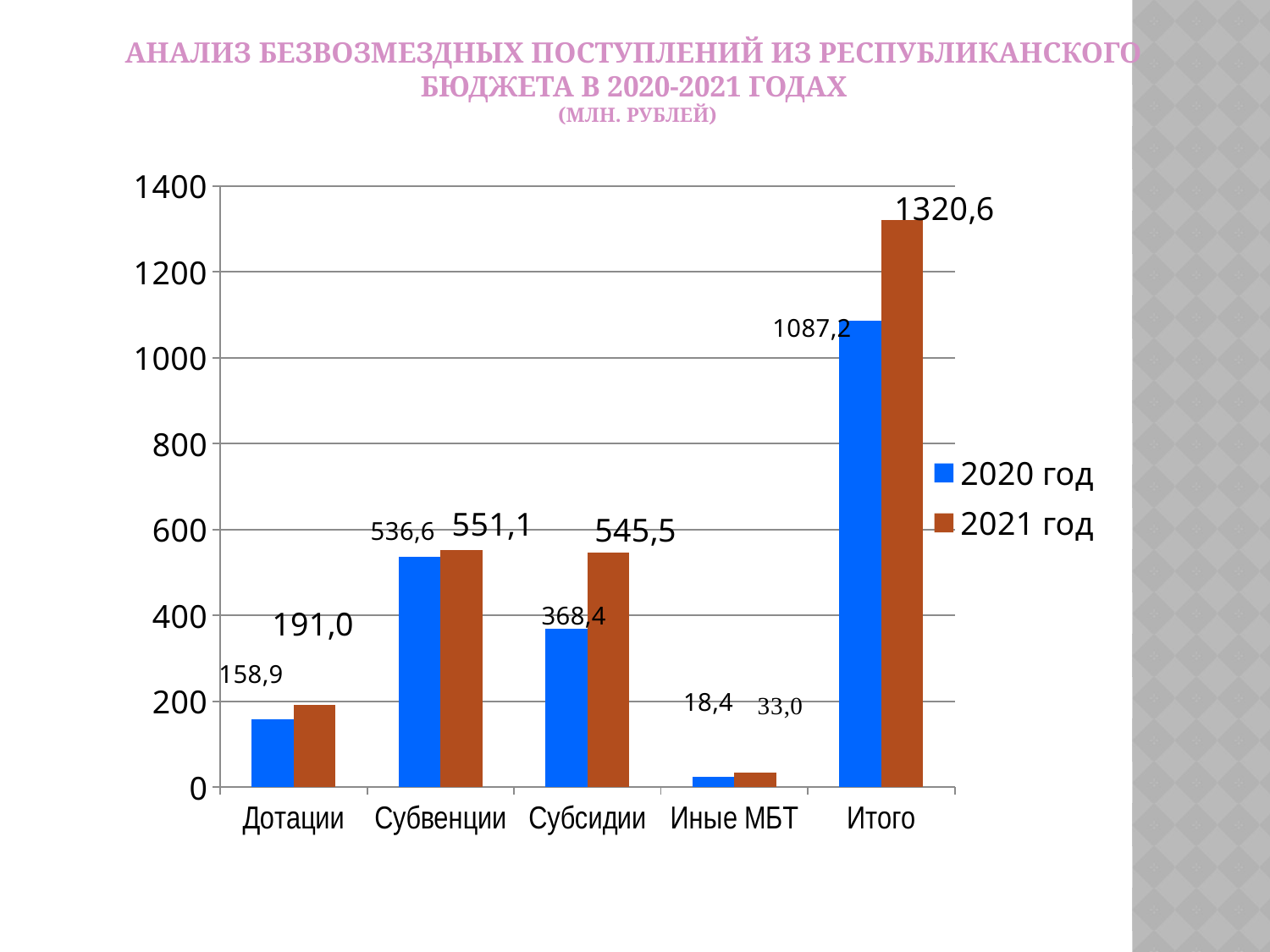
Which category has the lowest value in the 2020 год series? Иные МБТ Which is larger for Субвенции: the 2020 год value or the 2021 год value? 2021 год What is the difference between the 2021 год and 2020 год values for Субсидии? 177,1 Is the 2020 год value for Итого greater or less than 1000? greater How many series does the legend list? 2 How many categories are shown on the x axis? 5 What is the value for Субсидии in the 2021 год series? 545,5 What kind of chart is shown on the slide? bar chart What is the value for Дотации in the 2020 год series? 158,9 What is the value for Иные МБТ in the 2021 год series? 33,0 Which category has the highest value in the 2021 год series? Итого What is the difference between the 2021 год and 2020 год values for Итого? 233,4